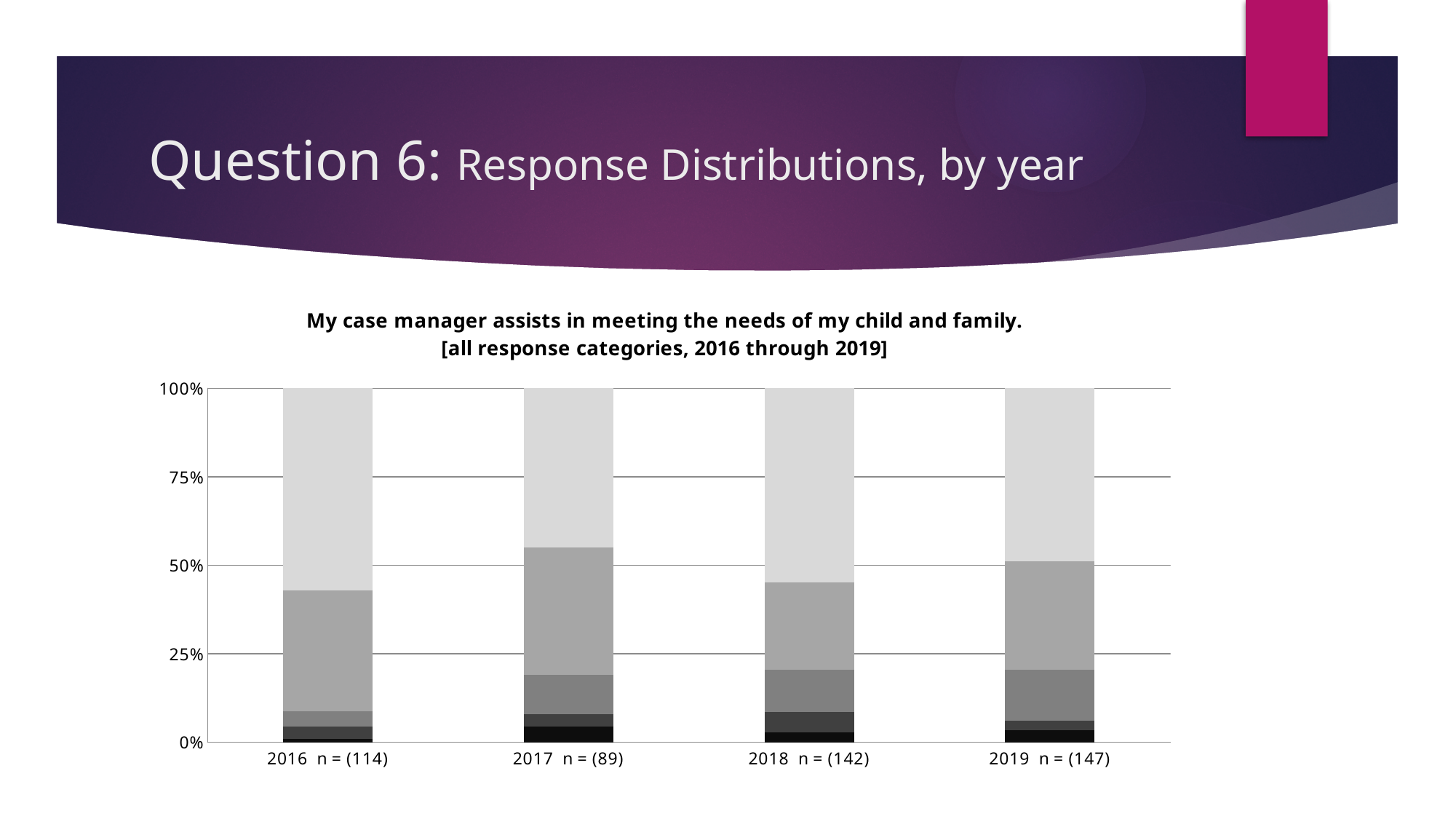
What is the n value shown for 2019? 147 What is the total height of each stacked bar? 100% In the 2016 bar, is the boundary where the lightest (top) segment begins greater or less than 50%? less Which year has the smallest n value? 2017 What is the difference between the n values for 2018 and 2016? 28 How many years (bars) are shown in the chart? 4 What is the title of the chart? My case manager assists in meeting the needs of my child and family. [all response categories, 2016 through 2019] What is the n value shown for 2017? 89 Which year has the largest n value? 2019 What kind of chart is shown on the slide? Stacked bar chart In the 2017 bar, is the boundary where the lightest (top) segment begins greater or less than 50%? greater Which bar has the larger lightest (top) segment, 2016 or 2017? 2016